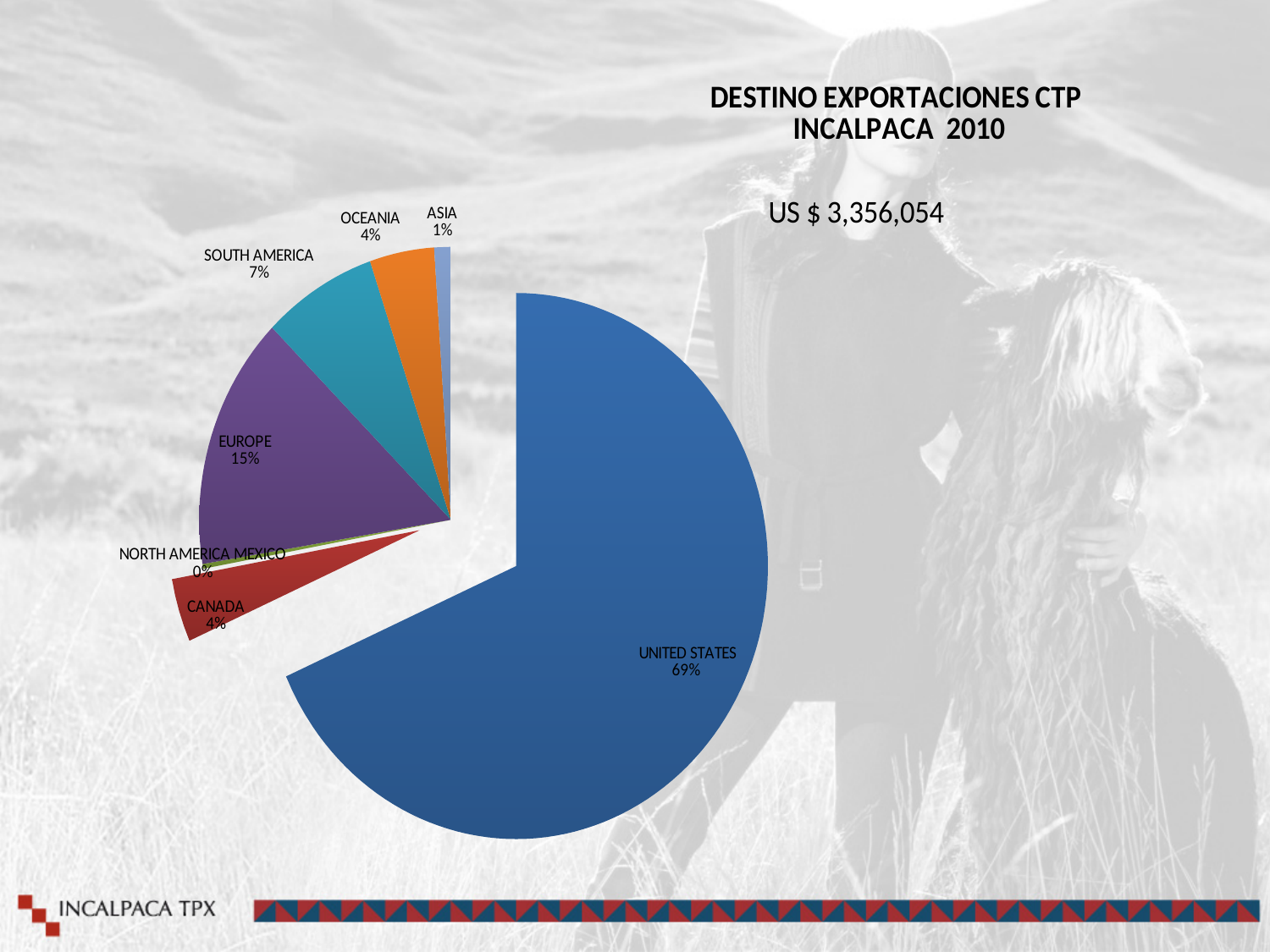
What total export value is printed on the slide? US $ 3,356,054 What is the difference in percentage points between the Europe share and the South America share? 8 percentage points What share of exports goes to South America? 7% Which destination has the smallest share of exports? North America Mexico How many destination slices does the pie chart show? 7 What kind of chart is shown on the slide? Pie chart What share of exports goes to Europe? 15% Which has a larger share of exports, Europe or Canada? Europe What share of exports goes to Asia? 1% Which destination has the largest share of exports? United States